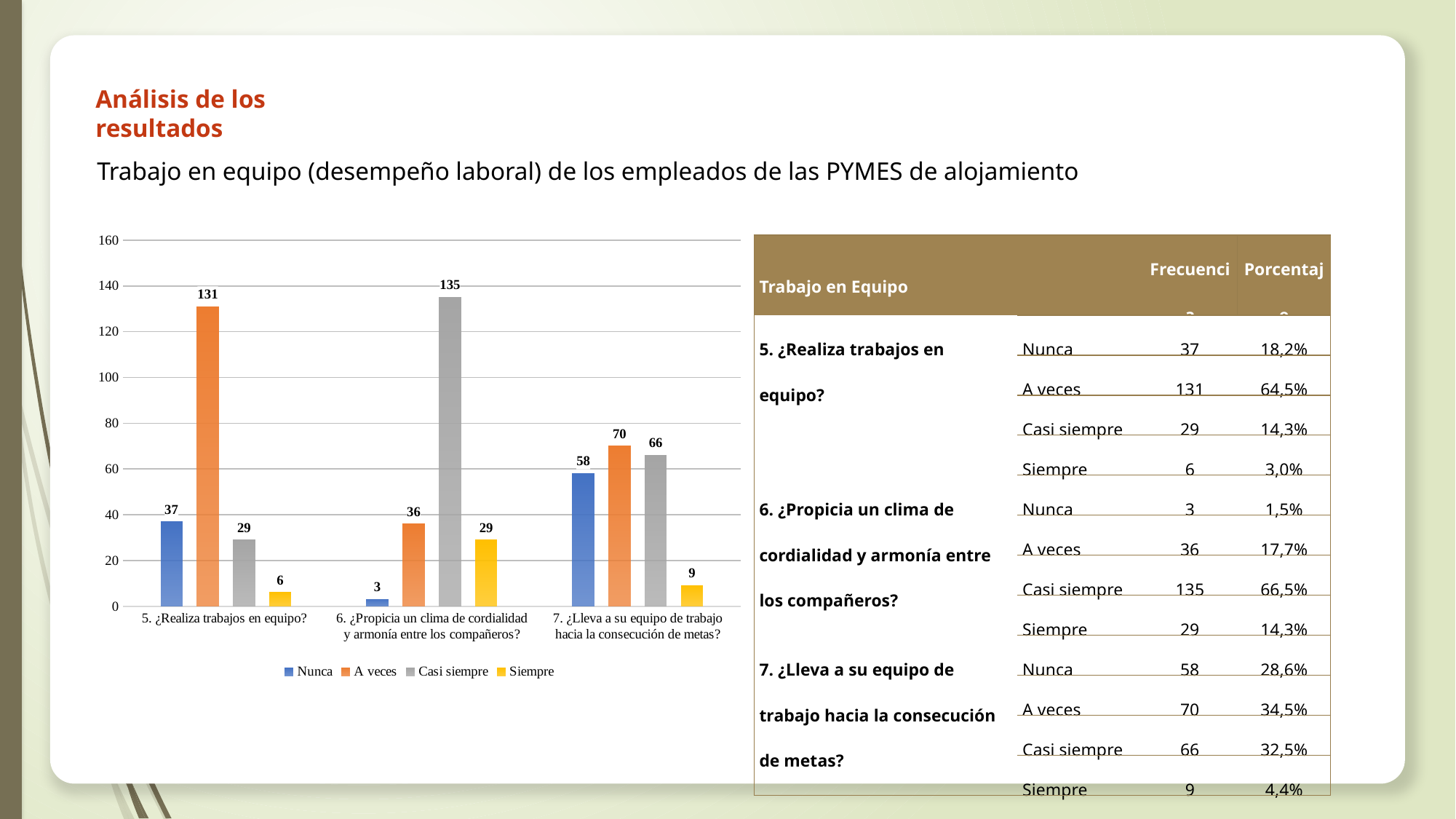
What is the difference between the 'A veces' value for question 5 and the 'A veces' value for question 7? 61 Which is larger: the 'Nunca' value for question 5 or the 'Nunca' value for question 7? question 7 (58) What is the value of 'A veces' for question 5 (¿Realiza trabajos en equipo?)? 131 What is the value of 'Casi siempre' for question 6 (¿Propicia un clima de cordialidad y armonía entre los compañeros?)? 135 What type of chart is shown on the slide? bar chart How many question categories are shown on the x axis of the chart? 3 What is the value of 'Siempre' for question 7 (¿Lleva a su equipo de trabajo hacia la consecución de metas?)? 9 Which response option has the lowest value for question 6 (¿Propicia un clima de cordialidad y armonía entre los compañeros?)? Nunca Which response option has the highest value for question 7 (¿Lleva a su equipo de trabajo hacia la consecución de metas?)? A veces Which colour represents the 'Siempre' series in the chart? yellow Is the 'Casi siempre' value for question 6 greater or less than 120? greater How many series does the chart legend list? 4